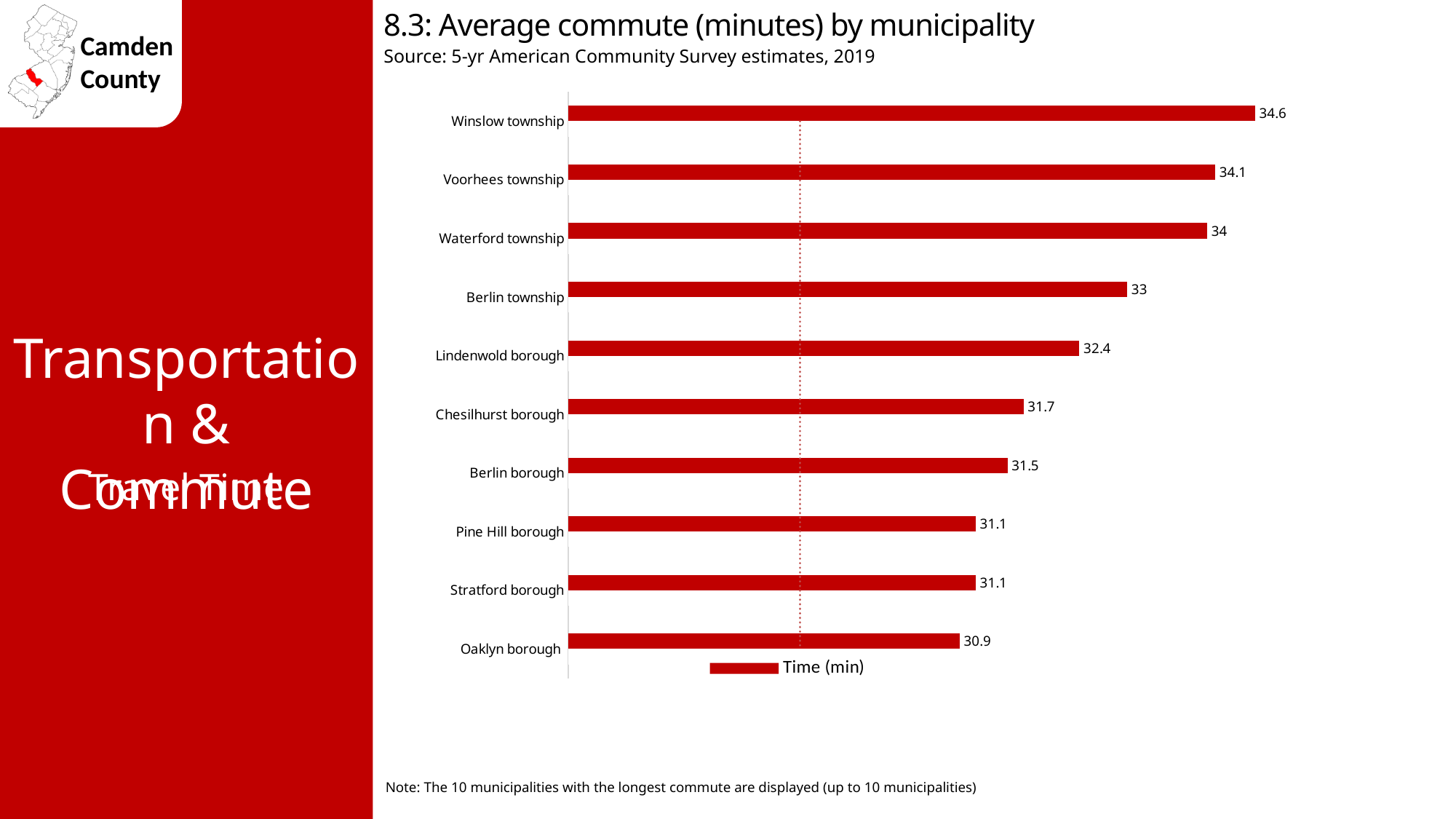
What is the average commute time for Oaklyn borough? 30.9 What is the difference in average commute time between Berlin township and Berlin borough? 1.5 What is the legend entry for the series in the chart? Time (min) What is the average commute time for Lindenwold borough? 32.4 What is the difference in average commute time between Winslow township and Oaklyn borough? 3.7 Which municipality has the longest average commute? Winslow township Which has a longer average commute, Chesilhurst borough or Pine Hill borough? Chesilhurst borough Which has a longer average commute, Voorhees township or Waterford township? Voorhees township What type of chart is used to show average commute by municipality? Bar chart What is the average commute time for Winslow township? 34.6 Which municipality has the shortest average commute among those shown? Oaklyn borough How many municipalities are shown in the chart? 10